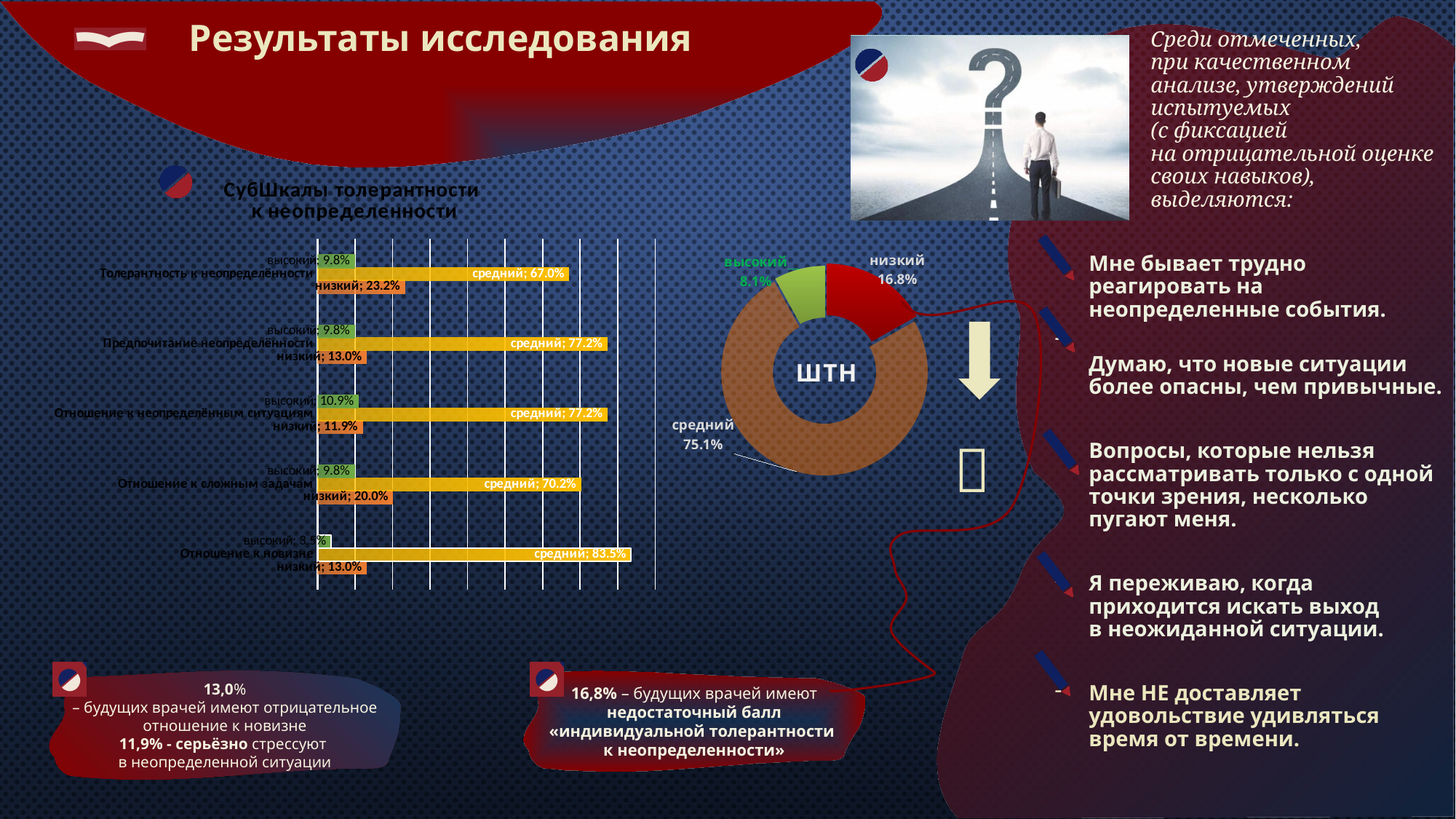
In the doughnut chart 'ШТН', what is the share of 'средний'? 75.1% In the bar chart 'Субшкалы толерантности к неопределенности', what is the value of 'высокий' for 'Отношение к неопределённым ситуациям'? 10.9% In the bar chart 'Субшкалы толерантности к неопределенности', what is the value of 'низкий' for 'Толерантность к неопределённости'? 23.2% In the bar chart 'Субшкалы толерантности к неопределенности', which category has the highest 'средний' value? Отношение к новизне In the bar chart 'Субшкалы толерантности к неопределенности', which category has the lowest 'высокий' value? Отношение к новизне In the doughnut chart 'ШТН', what is the difference between the 'низкий' and 'высокий' shares? 8.7% In the bar chart 'Субшкалы толерантности к неопределенности', what is the difference between the 'низкий' values for 'Толерантность к неопределённости' and 'Отношение к сложным задачам'? 3.2% In the bar chart 'Субшкалы толерантности к неопределенности', which is larger: the 'средний' value for 'Толерантность к неопределённости' or for 'Отношение к сложным задачам'? Отношение к сложным задачам What type of chart is the 'Субшкалы толерантности к неопределенности' chart? Bar chart In the bar chart 'Субшкалы толерантности к неопределенности', what is the value of 'средний' for 'Отношение к новизне'? 83.5% How many categories are shown in the bar chart 'Субшкалы толерантности к неопределенности'? 5 In the doughnut chart 'ШТН', which slice is the smallest? высокий